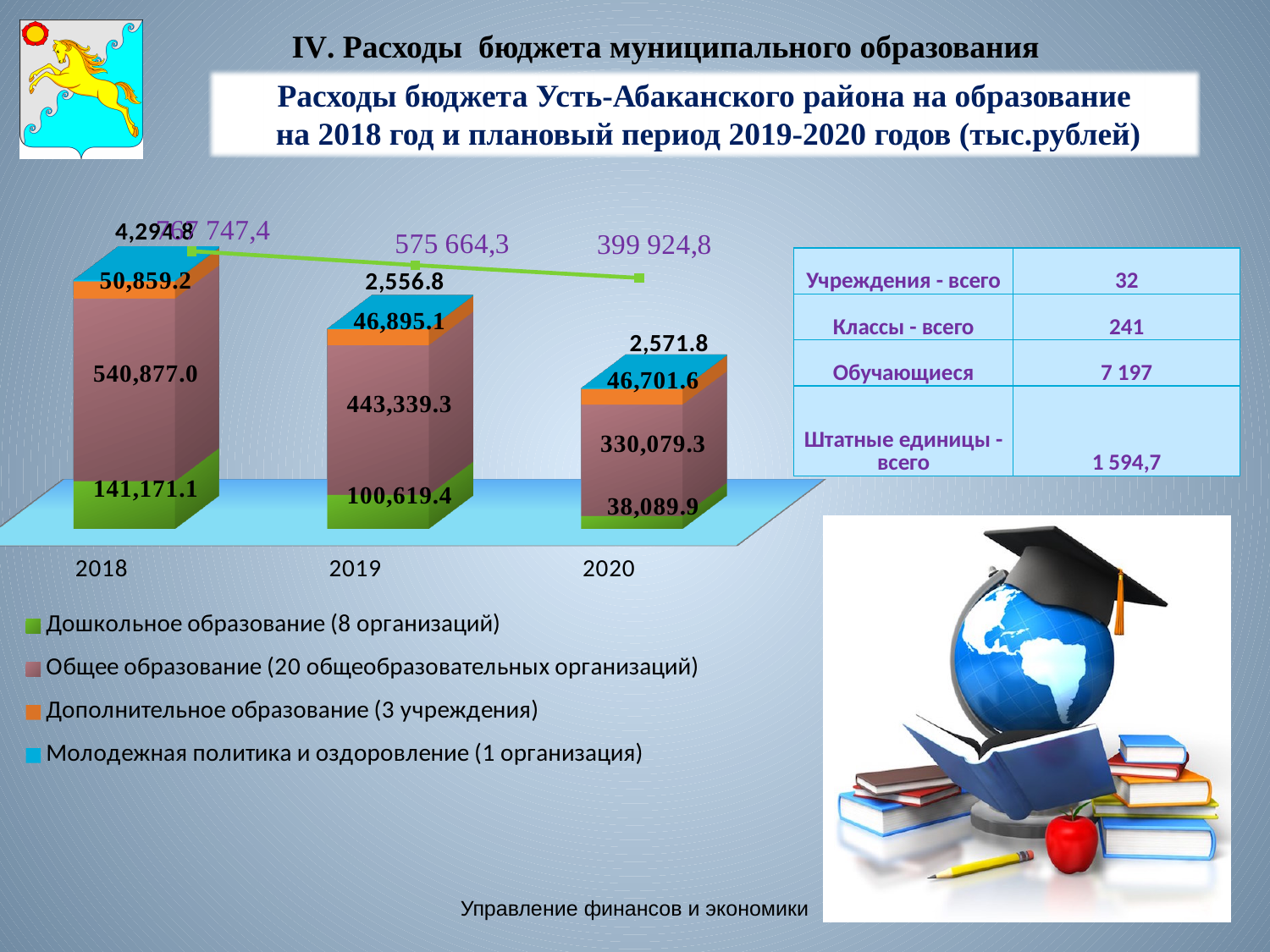
How many series does the legend list? 4 What is the value for Дошкольное образование in 2020? 38,089.9 Does the value for Общее образование rise or fall from 2018 to 2020? fall What is the value for Молодежная политика и оздоровление in 2020? 2,571.8 What is the value for Общее образование in 2018? 540,877.0 What is the difference between the Дошкольное образование values for 2018 and 2019? 40,551.7 In which year is the value for Дошкольное образование the lowest? 2020 What is the value for Дополнительное образование in 2019? 46,895.1 Which year has the larger value for Дополнительное образование, 2019 or 2020? 2019 How many years are shown on the x axis of the chart? 3 In which year is the value for Общее образование the highest? 2018 What value is printed above the 2019 bar on the line? 575 664,3